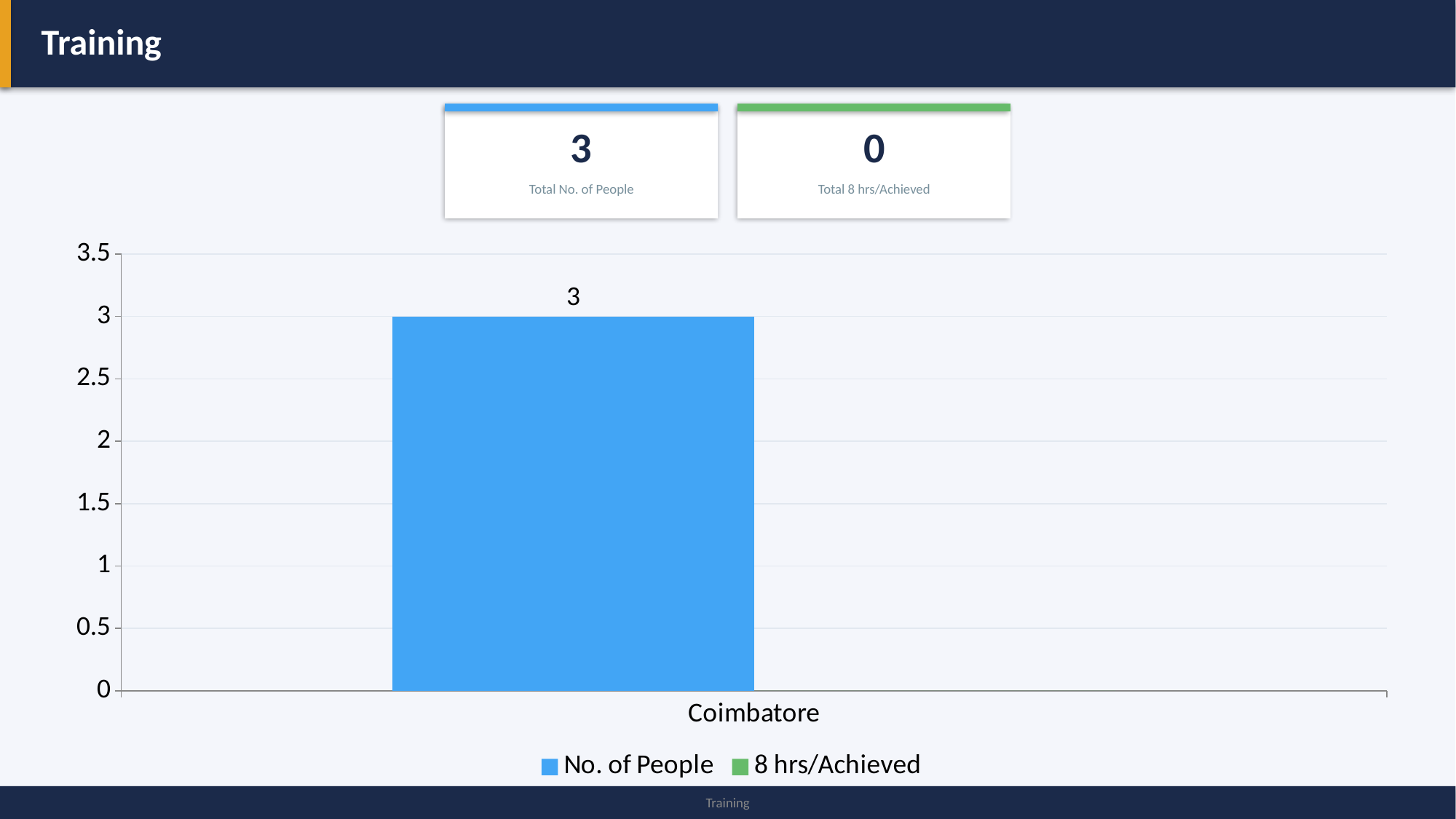
Which series has the larger value for Coimbatore, No. of People or 8 hrs/Achieved? No. of People How many series does the legend list? 2 Is the value of No. of People for Coimbatore greater or less than 3.5? less Is the value of No. of People for Coimbatore greater or less than 2? greater What is the name of the only category on the x axis? Coimbatore What is the value of No. of People for Coimbatore? 3 What kind of chart is shown on the slide? bar chart What is the highest value shown on the y axis? 3.5 What colour is the No. of People series in the legend? blue How many categories are shown on the x axis? 1